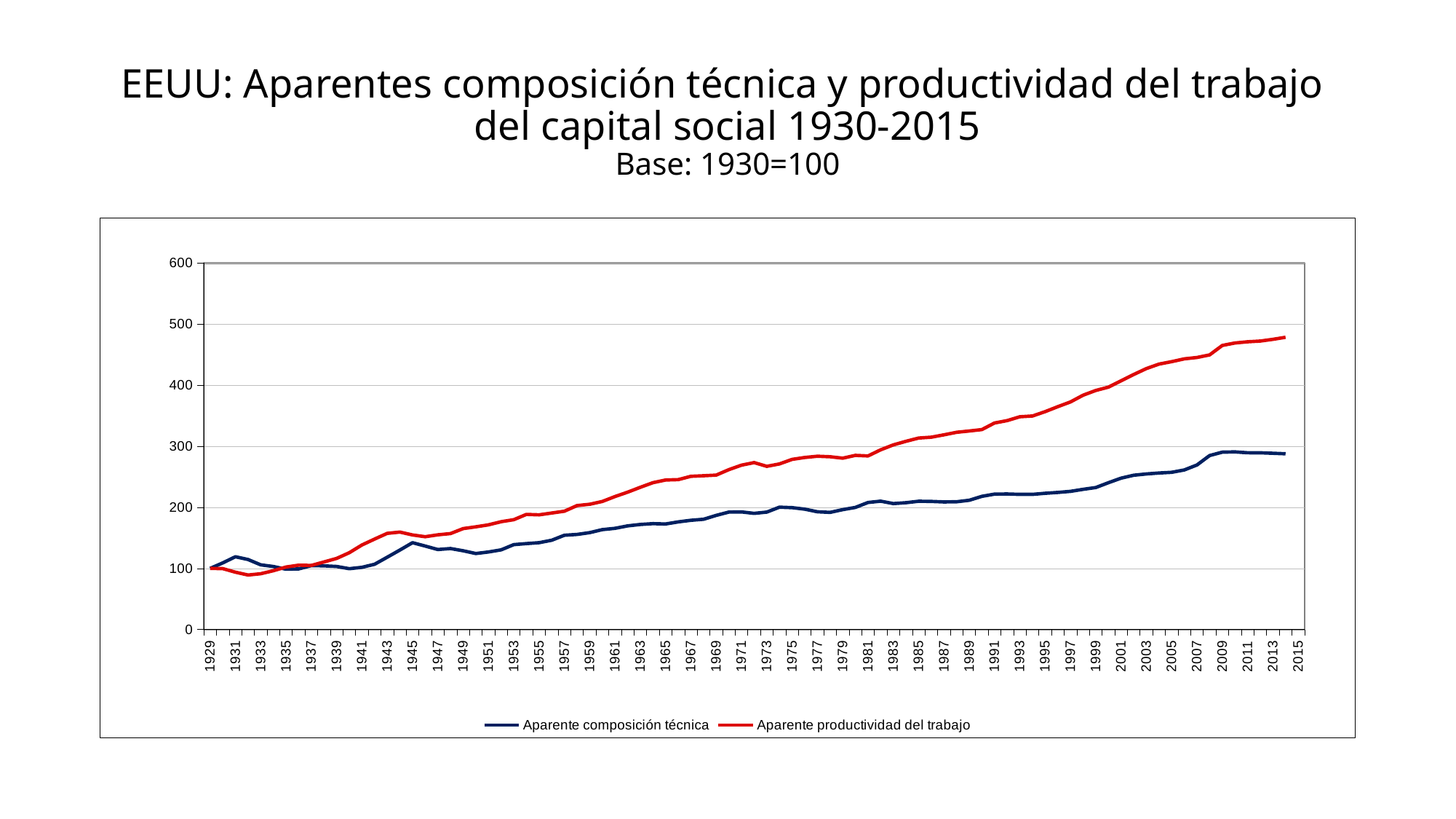
Is the value for Aparente productividad del trabajo in 1965 greater or less than 200? greater What base year and value does the subtitle state for the index? 1930=100 Which series is drawn in red? Aparente productividad del trabajo Is the value for Aparente composición técnica in 2013 greater or less than 300? less Is the value for Aparente composición técnica in 2001 greater or less than 200? greater In 1931, which series has the higher value, Aparente composición técnica or Aparente productividad del trabajo? Aparente composición técnica Overall, does the Aparente productividad del trabajo series rise or fall from 1929 to 2015? rise In 2013, which series has the higher value, Aparente composición técnica or Aparente productividad del trabajo? Aparente productividad del trabajo How many series does the legend list? 2 What kind of chart is shown on the slide? line chart